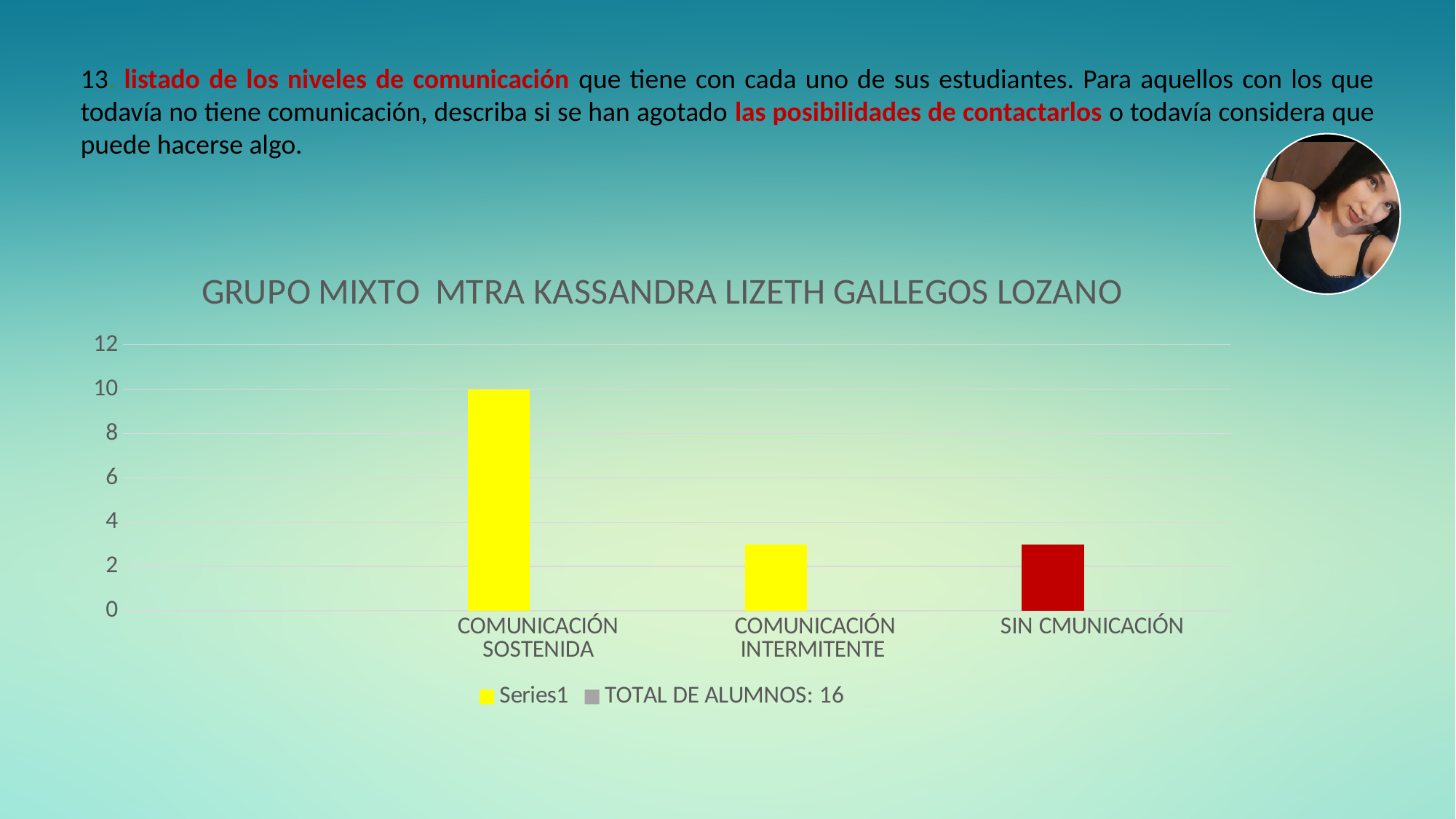
What is the title of the chart? GRUPO MIXTO MTRA KASSANDRA LIZETH GALLEGOS LOZANO What is the highest value shown on the vertical axis? 12 How many categories are shown on the x axis? 3 Which category has the highest value? COMUNICACIÓN SOSTENIDA What is the value for COMUNICACIÓN SOSTENIDA? 10 Is the value for COMUNICACIÓN SOSTENIDA greater or less than 8? greater What colour is the bar for SIN CMUNICACIÓN? red Is the value for COMUNICACIÓN INTERMITENTE greater or less than 4? less Which is larger, the value for COMUNICACIÓN SOSTENIDA or the value for COMUNICACIÓN INTERMITENTE? COMUNICACIÓN SOSTENIDA Is the value for SIN CMUNICACIÓN greater or less than 2? greater What type of chart is shown on the slide? bar chart How many entries does the legend list? 2